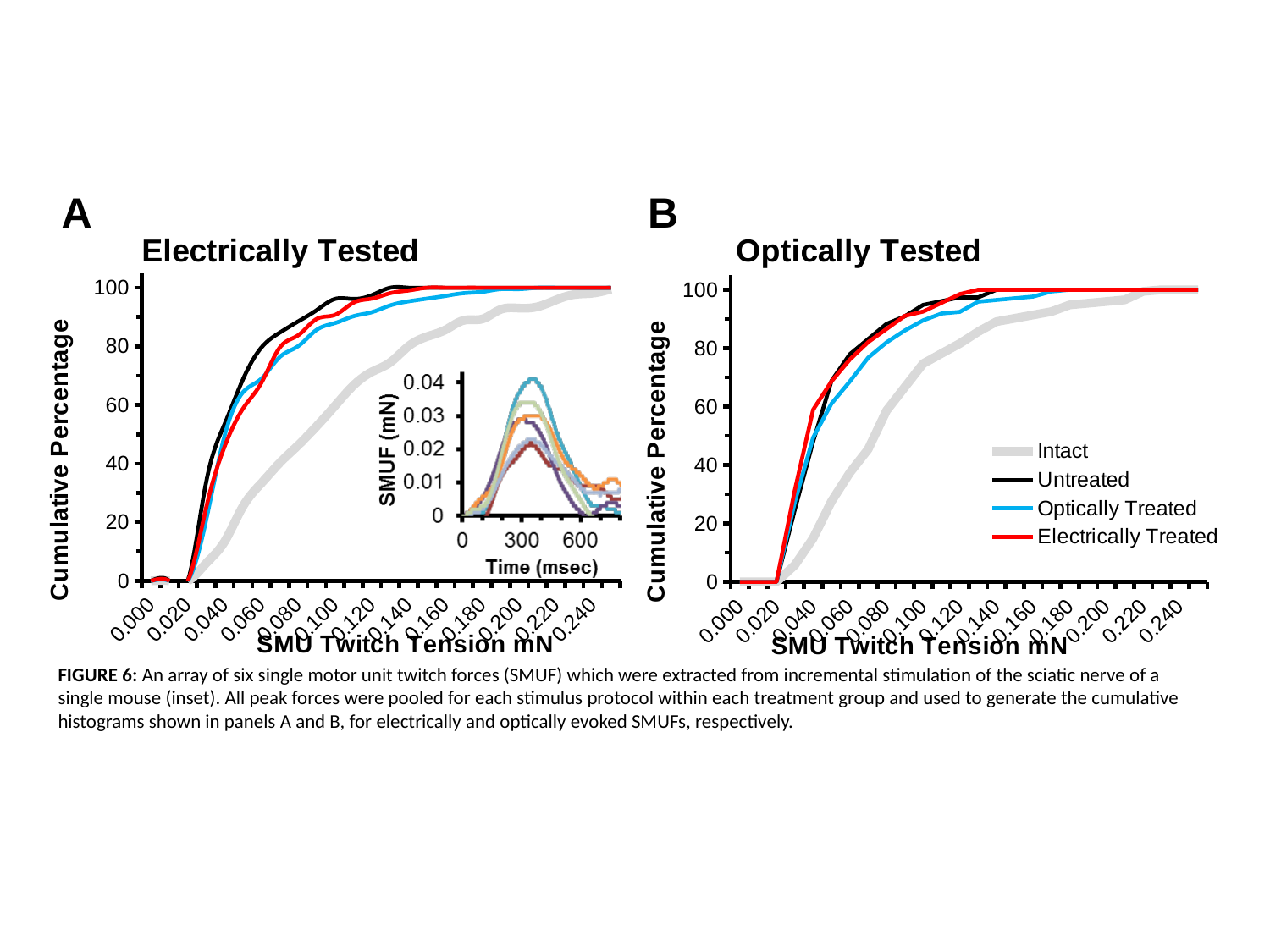
What kind of chart is the 'Electrically Tested' chart (panel A)? line chart In the 'Optically Tested' chart, at 0.100 mN, which is larger: the cumulative percentage for Untreated or for Intact? Untreated What is the x-axis label of the 'Optically Tested' chart? SMU Twitch Tension mN In the 'Electrically Tested' chart, at 0.060 mN, which is larger: the cumulative percentage for Electrically Treated or for Intact? Electrically Treated In the 'Electrically Tested' chart, is the cumulative percentage for Untreated at 0.060 mN greater or less than 60? greater In the 'Optically Tested' chart, is the cumulative percentage for Untreated at 0.100 mN greater or less than 80? greater Which colour represents the Intact series in the legend? grey How many series does the legend list? 4 In the 'Electrically Tested' chart, is the cumulative percentage for Intact at 0.060 mN greater or less than 40? less In the 'Electrically Tested' chart, do the values rise or fall as SMU Twitch Tension increases along the x axis? rise In the 'Optically Tested' chart, which series has the lowest cumulative percentage at 0.080 mN? Intact